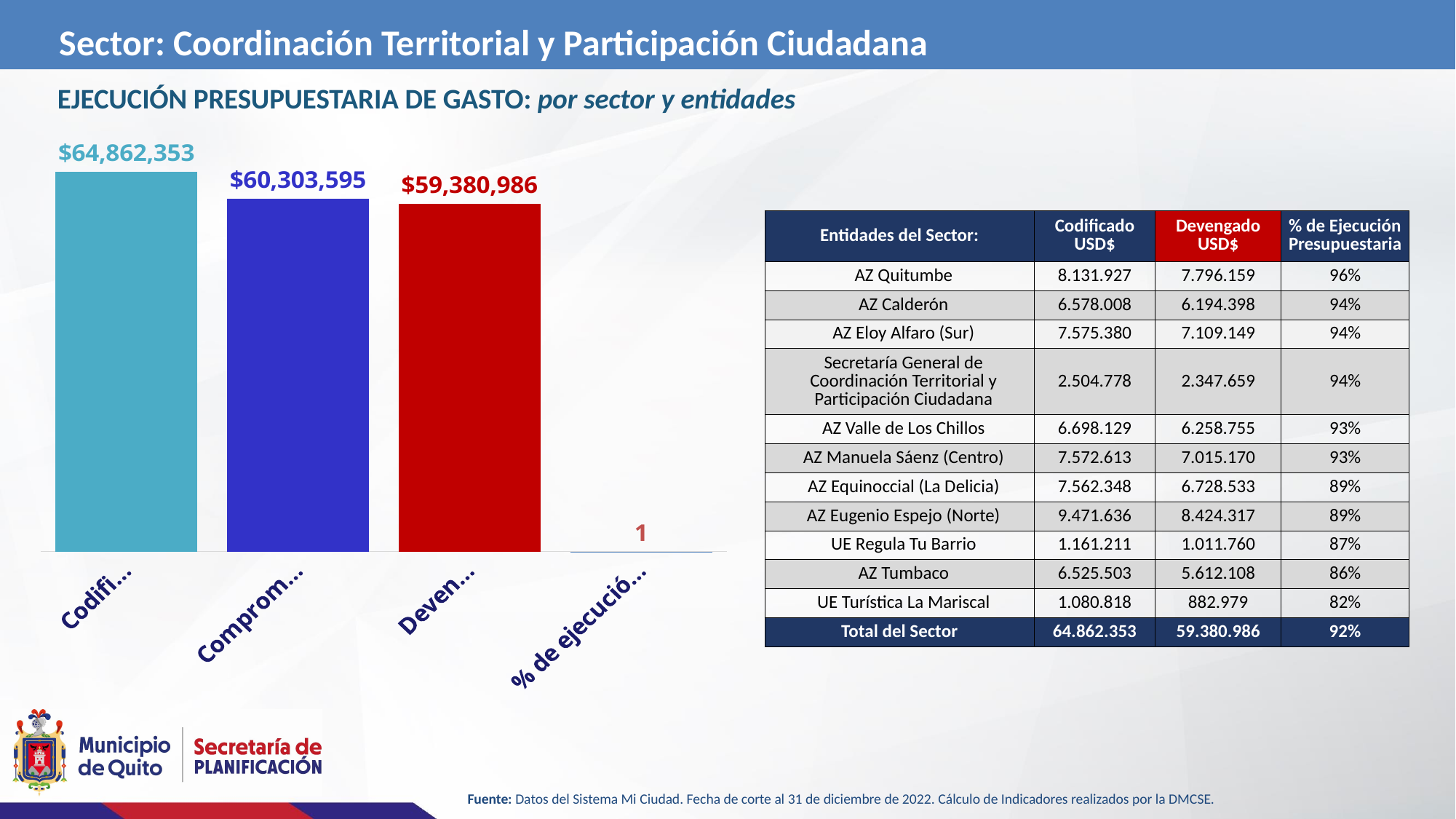
In the bar chart, which is larger: the "Comprom..." bar or the "Deven..." bar? Comprom... What is the difference between the "Comprom..." bar and the "Deven..." bar in the bar chart? $922,609 Which category has the lowest value in the bar chart? % de ejecució... What value is shown for the bar labelled "Deven..." in the bar chart? $59,380,986 Which category has the highest value in the bar chart? Codifi... (the first bar) What colour is the "Deven..." bar in the bar chart? Red What value is printed above the last category, "% de ejecució...", in the bar chart? 1 What is the difference between the "Codifi..." bar and the "Comprom..." bar in the bar chart? $4,558,758 What type of chart is shown on the left of the slide? Bar chart What value is shown for the first bar, labelled "Codifi...", in the bar chart? $64,862,353 How many categories are shown on the x axis of the bar chart? 4 What value is shown for the bar labelled "Comprom..." in the bar chart? $60,303,595